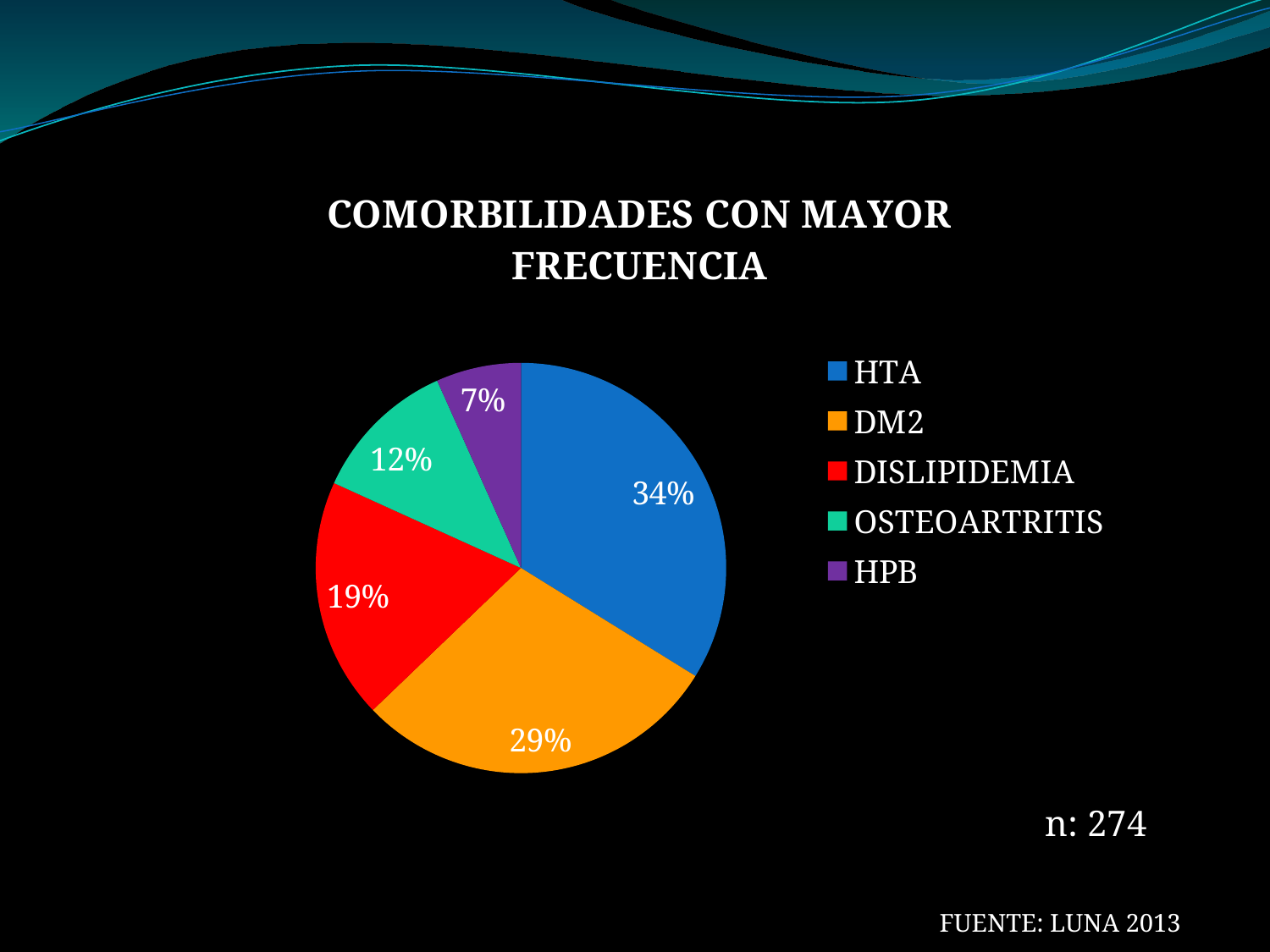
What percentage of the pie does HTA represent? 34% Which comorbidity has the smallest share of the pie? HPB What percentage of the pie does DM2 represent? 29% What type of chart is shown on the slide? pie chart Which is larger, the share for DISLIPIDEMIA or the share for OSTEOARTRITIS? DISLIPIDEMIA Which comorbidity has the largest share of the pie? HTA What percentage of the pie does DISLIPIDEMIA represent? 19% What percentage of the pie does OSTEOARTRITIS represent? 12% What is the title of the chart? COMORBILIDADES CON MAYOR FRECUENCIA How many categories does the legend list? 5 What percentage of the pie does HPB represent? 7% What is the difference in percentage points between HTA and DM2? 5